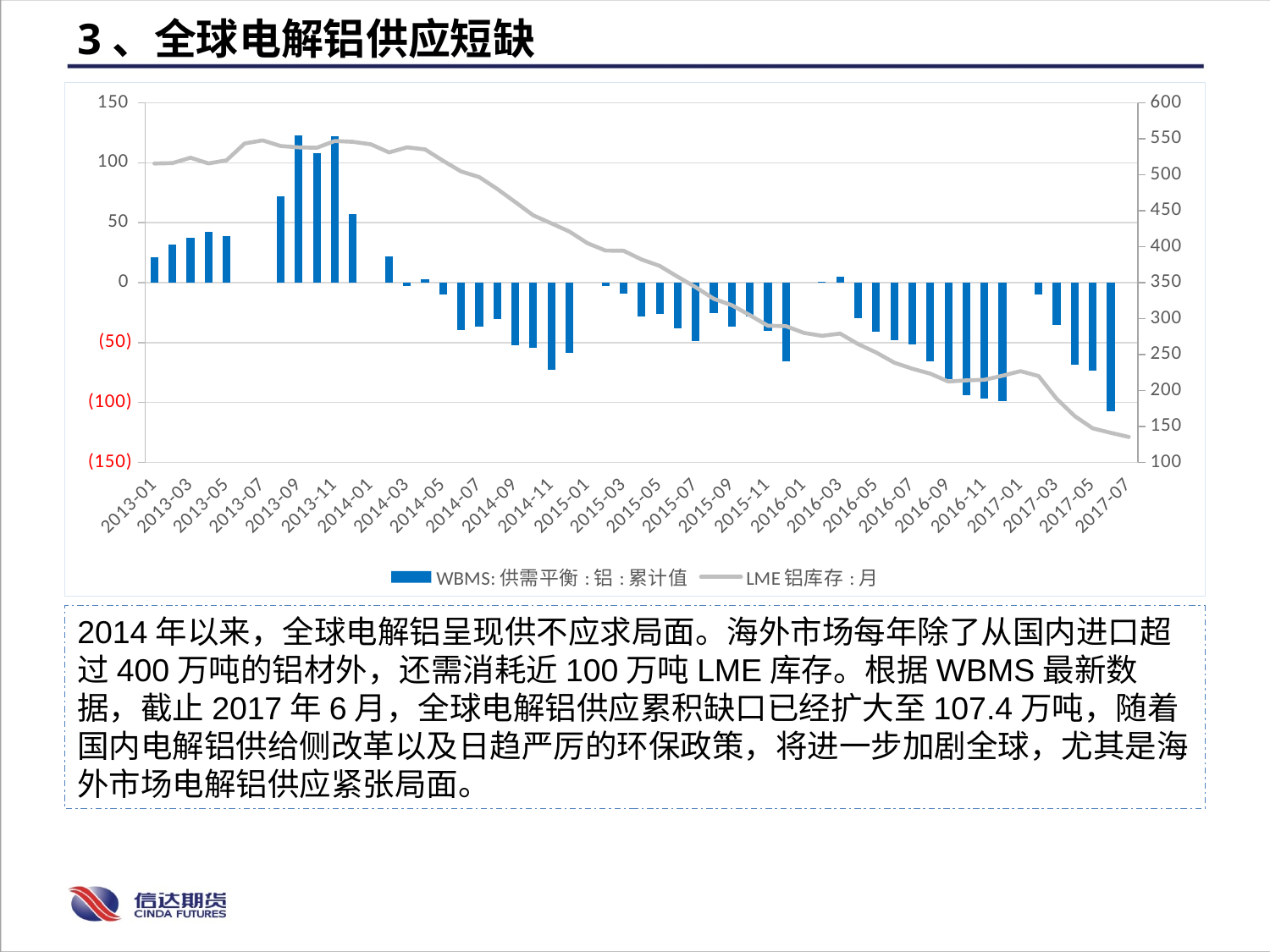
Is the WBMS 供需平衡 bar for 2013-09 greater or less than 100? greater Which series is drawn as bars in the chart? WBMS: 供需平衡 : 铝 : 累计值 Is the LME 铝库存 value at 2017-07 greater or less than 200? less Does the LME 铝库存 line rise or fall overall from 2013-01 to 2017-07? Fall Is the WBMS 供需平衡 bar for 2013-01 greater or less than 50? less Which series is drawn as a line in the chart? LME 铝库存 : 月 Which is larger, the WBMS 供需平衡 bar for 2013-09 or for 2013-01? 2013-09 What kind of chart is shown on the slide? A combination bar and line chart How many series does the chart legend list? 2